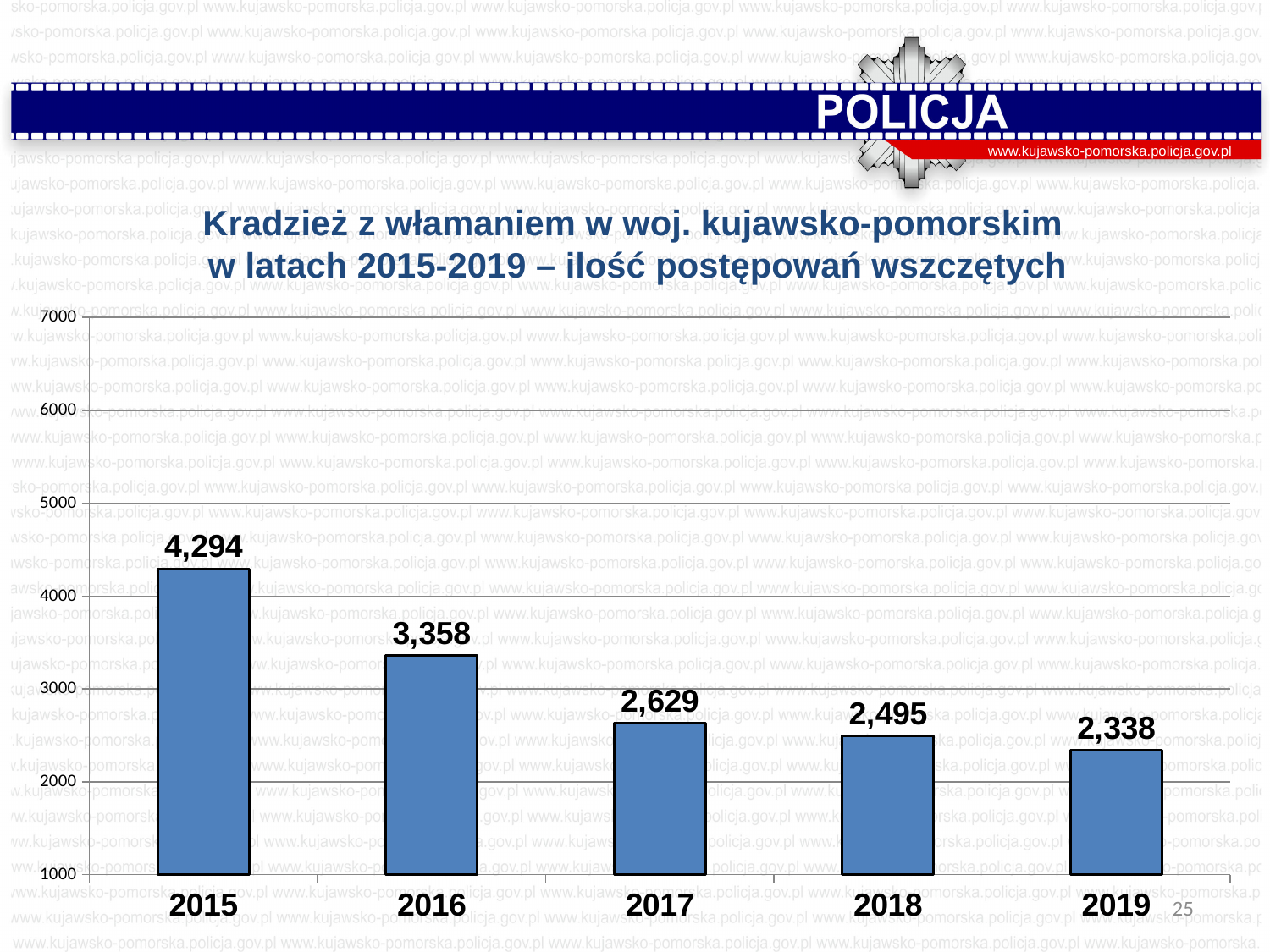
What is the value for 2017? 2,629 Which year has the lowest value? 2019 Do the values rise or fall from 2015 to 2019? fall How many years are shown on the x axis? 5 What is the value for 2015? 4,294 Is the value for 2016 greater or less than 3000? greater What is the difference between the values for 2018 and 2019? 157 Which year has the highest value? 2015 What is the value for 2019? 2,338 What is the difference between the values for 2015 and 2016? 936 What kind of chart is shown on the slide? bar chart Which is larger, the value for 2016 or the value for 2017? 2016